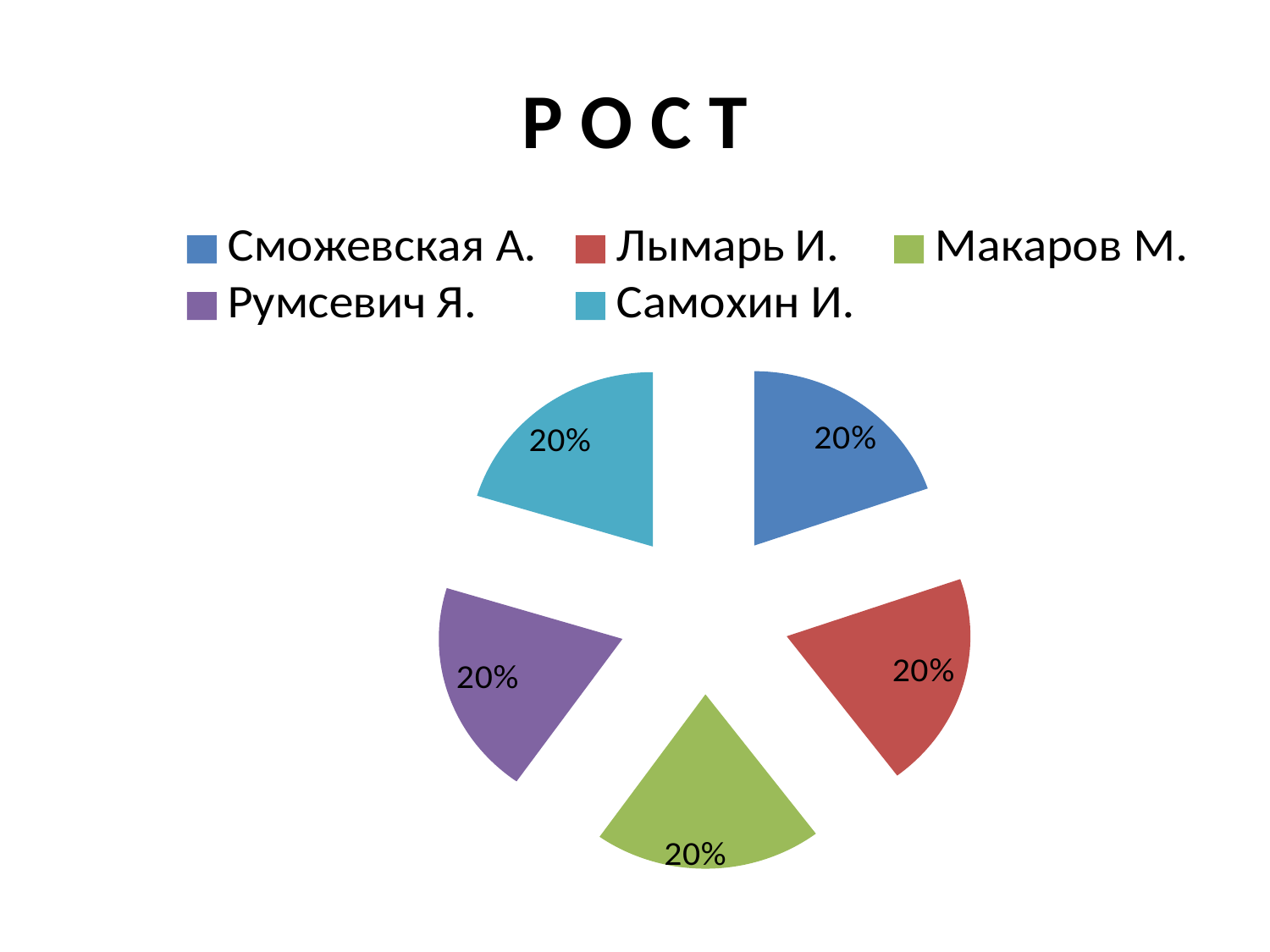
How many entries does the legend list? 5 Which legend entry is shown in blue? Сможевская А. What share of the pie does Самохин И. have? 20% What kind of chart is shown on the slide? pie chart What is the title of the chart? Р О С Т What share of the pie does Сможевская А. have? 20% What share of the pie does Лымарь И. have? 20% What is the difference between the shares of Сможевская А. and Самохин И.? 0% How many slices does the pie chart have? 5